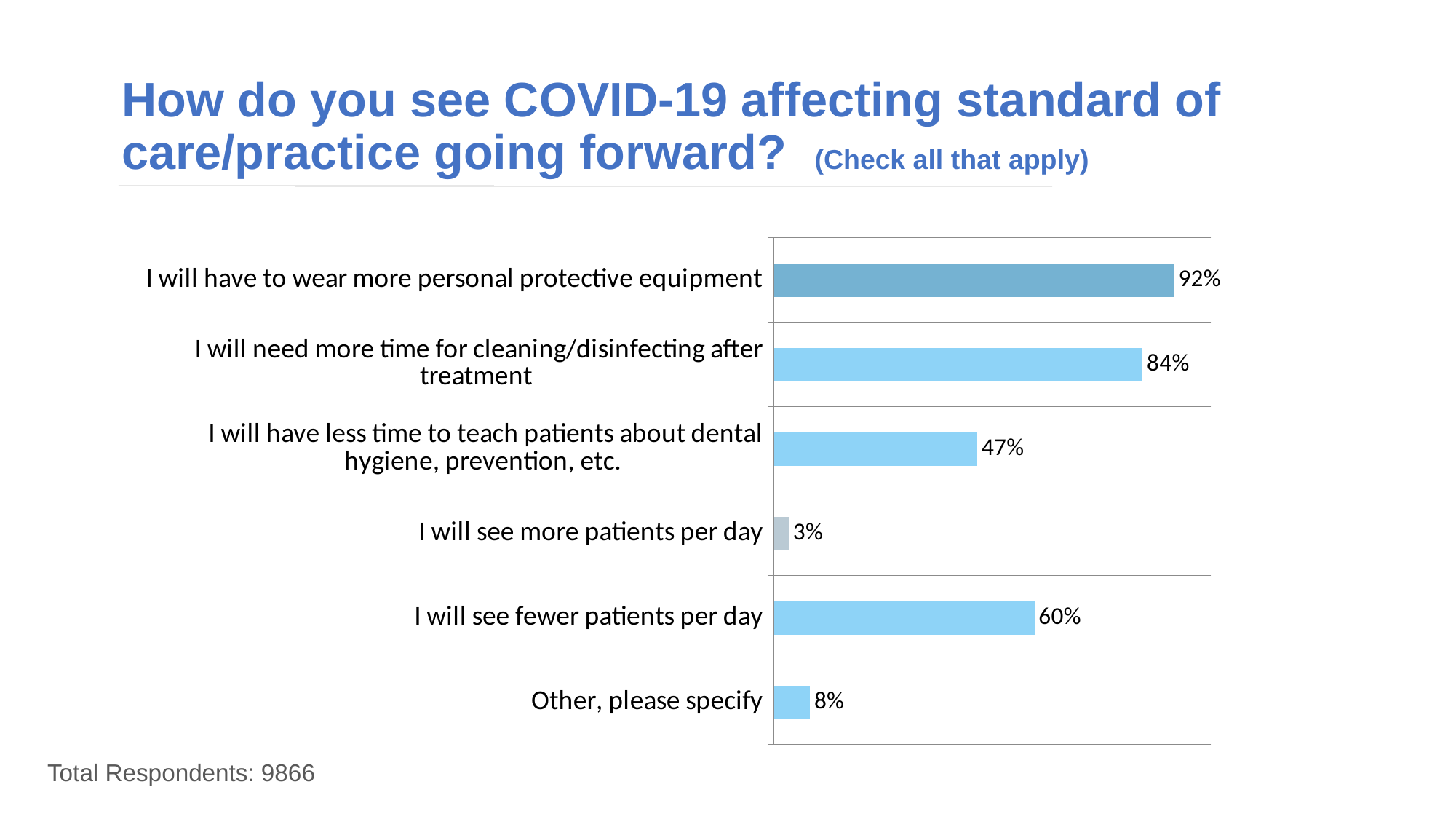
What percentage of respondents chose 'Other, please specify'? 8% Which response has the highest percentage? I will have to wear more personal protective equipment What type of chart is shown on the slide? Bar chart What is the difference in percentage points between 'I will see fewer patients per day' and 'I will see more patients per day'? 57 Which response has the lowest percentage? I will see more patients per day What is the difference in percentage points between 'I will have to wear more personal protective equipment' and 'I will need more time for cleaning/disinfecting after treatment'? 8 What percentage of respondents said they will need more time for cleaning/disinfecting after treatment? 84% What percentage of respondents said they will see fewer patients per day? 60% How many response categories are shown in the chart? 6 What percentage of respondents said they will have to wear more personal protective equipment? 92% Which is larger: the percentage for 'I will have less time to teach patients about dental hygiene, prevention, etc.' or for 'I will see fewer patients per day'? I will see fewer patients per day How many total respondents are noted on the slide? 9866